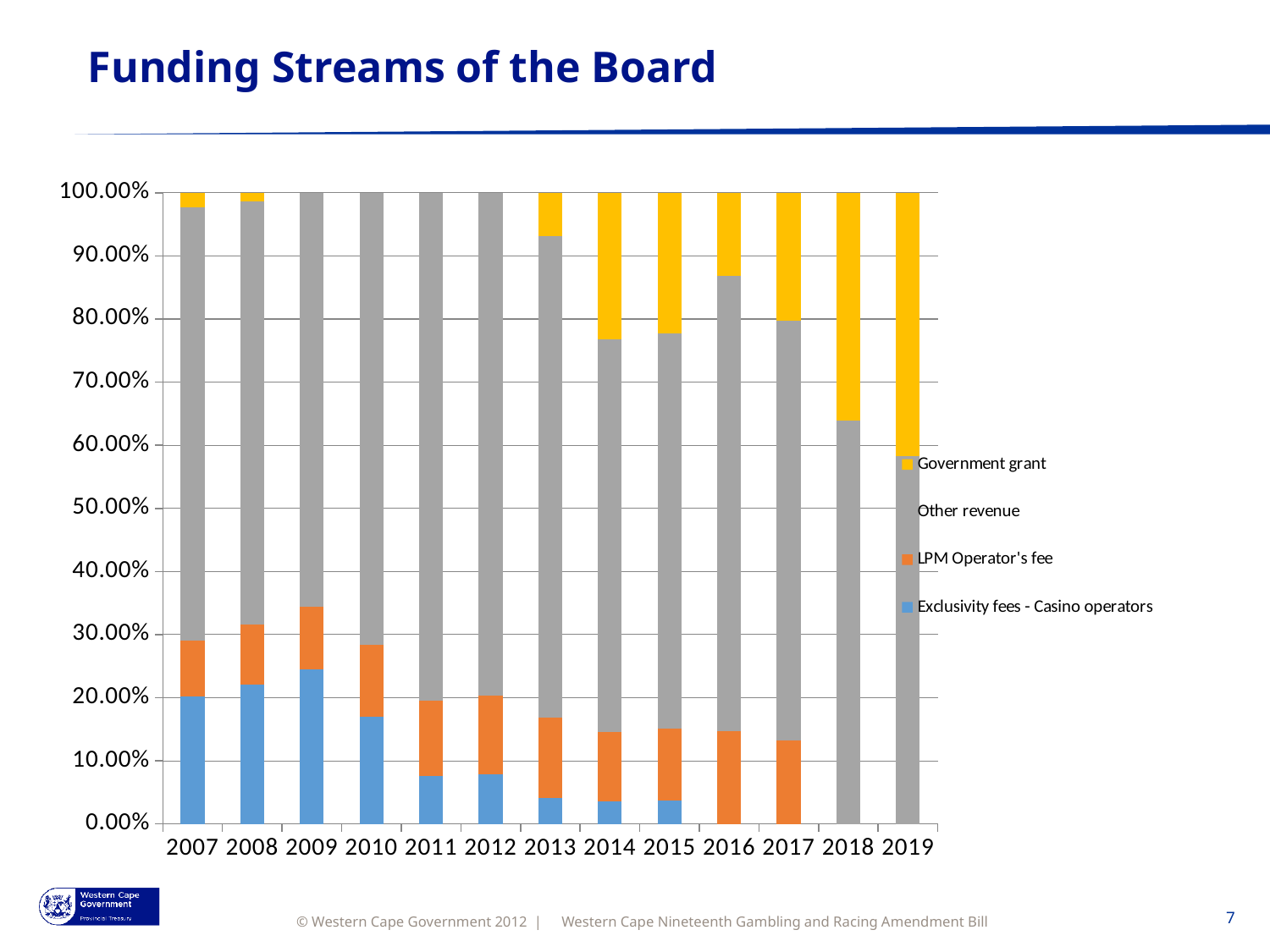
How many years show no Exclusivity fees - Casino operators segment at all? 4 How many years are shown on the x axis of the chart? 13 Is the Government grant share in 2019 greater or less than 30.00%? greater What kind of chart is shown on the slide? Stacked bar chart Does the Exclusivity fees - Casino operators share rise or fall from 2009 to 2015? fall Which year has the largest Government grant share? 2019 How many series does the legend list? 4 Is the Exclusivity fees - Casino operators share in 2009 greater or less than 20.00%? greater Which year has a larger Exclusivity fees - Casino operators share, 2007 or 2011? 2007 Which legend entry is listed last (at the bottom) in the legend? Exclusivity fees - Casino operators Is the Exclusivity fees - Casino operators share in 2014 greater or less than 10.00%? less Which series is shown in yellow? Government grant